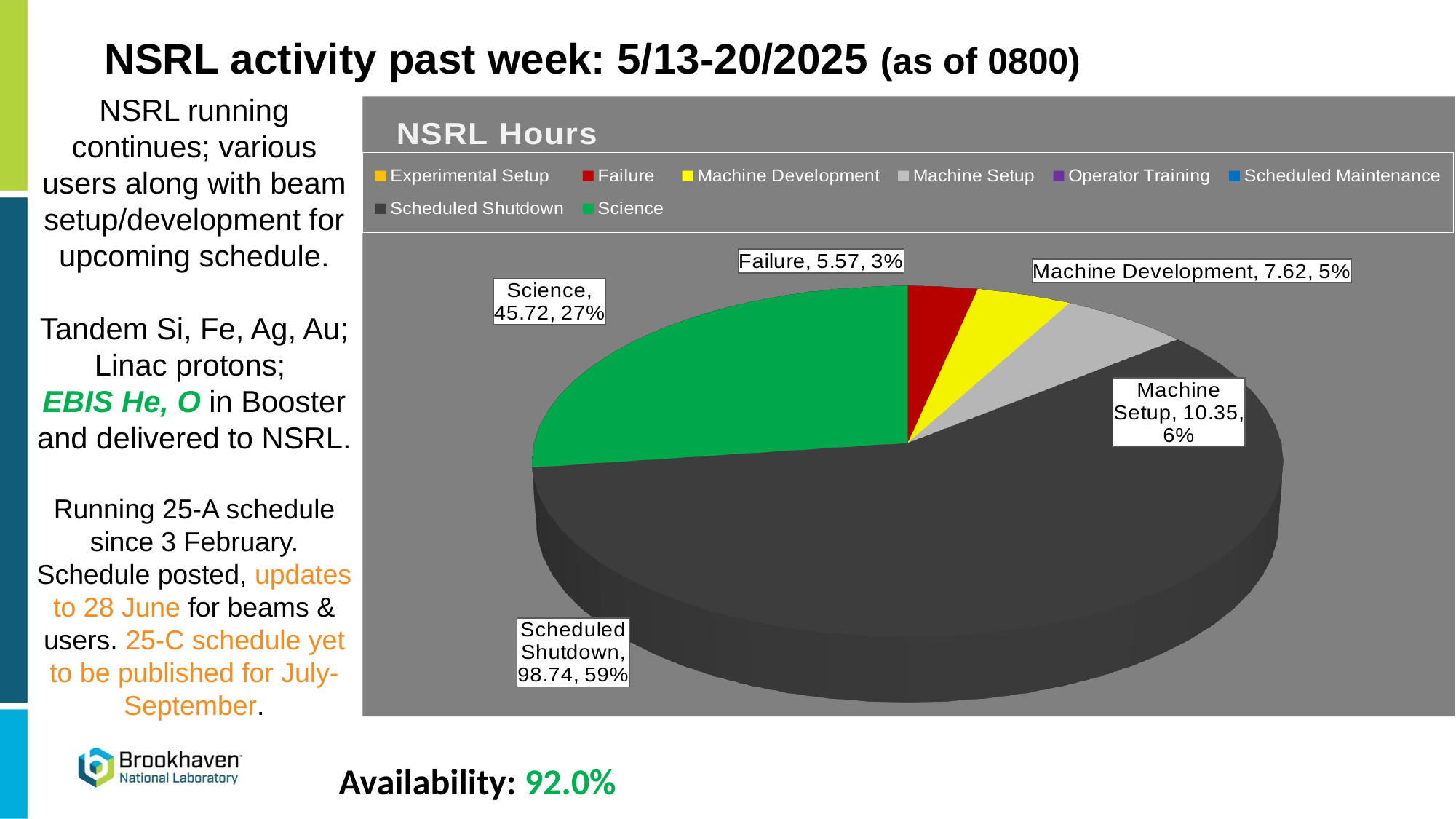
What percentage share of the pie does Machine Development have? 5% How many entries does the chart legend list? 8 Which category has the largest slice of the pie? Scheduled Shutdown How many hours are shown for Failure? 5.57 What is the difference in hours between Scheduled Shutdown and Science? 53.02 What type of chart is shown on the slide? pie chart What is the title of the chart? NSRL Hours How many hours are shown for Science? 45.72 How many hours are shown for Scheduled Shutdown? 98.74 Which labelled category has the smallest slice of the pie? Failure What percentage share of the pie does Machine Setup have? 6% Which has more hours, Machine Setup or Machine Development? Machine Setup